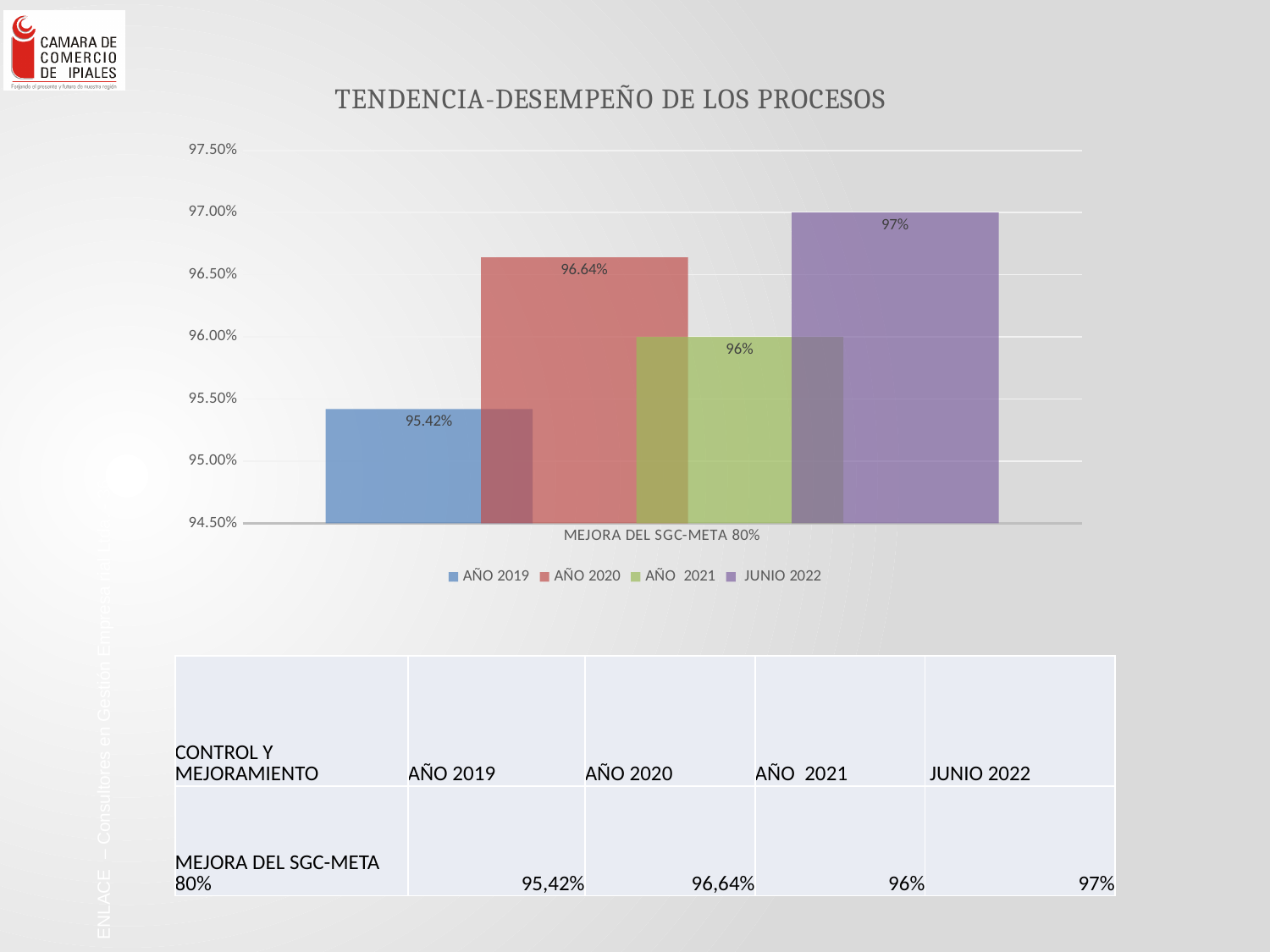
Which is larger, the value for AÑO 2020 or the value for AÑO 2021? AÑO 2020 What is the value for JUNIO 2022 in the chart? 97% What kind of chart is shown on the slide? bar chart What is the value for AÑO 2019 in the chart? 95.42% What is the title of the chart? TENDENCIA-DESEMPEÑO DE LOS PROCESOS What is the value for AÑO 2020 in the chart? 96.64% Which series has the highest value in the chart? JUNIO 2022 What is the value for AÑO 2021 in the chart? 96% Is the value for AÑO 2019 greater or less than 95.50%? less How many series does the legend list? 4 Which series has the lowest value in the chart? AÑO 2019 What is the difference between the values for JUNIO 2022 and AÑO 2019? 1.58%